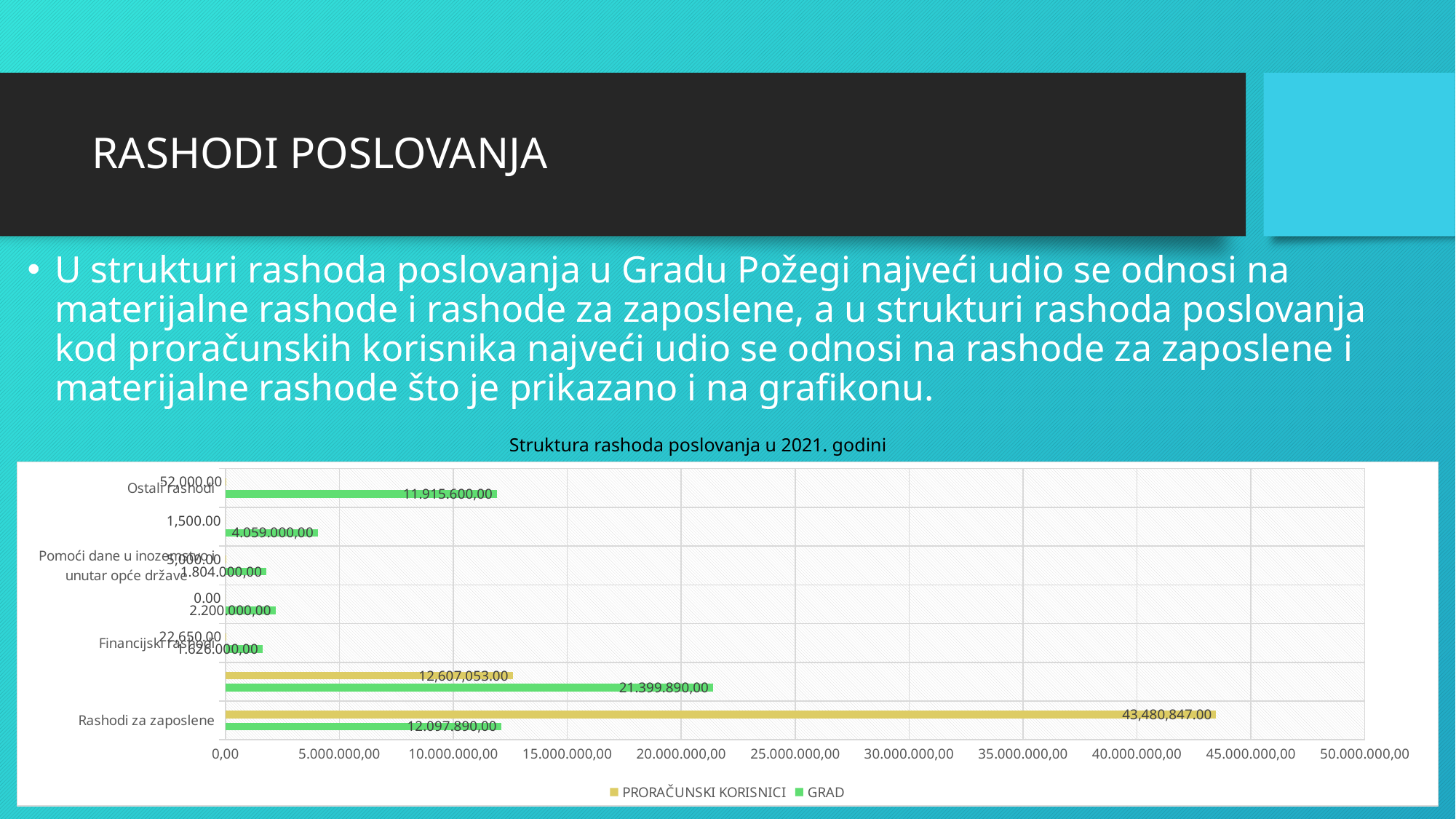
How many series does the chart legend list? 2 What is the GRAD value for Rashodi za zaposlene? 12.097.890,00 What kind of chart is shown on the slide? bar chart What is the GRAD value for Ostali rashodi? 11.915.600,00 How many categories are plotted on the chart? 7 What is the largest GRAD value shown on the chart? 21.399.890,00 What is the PRORAČUNSKI KORISNICI value for Rashodi za zaposlene? 43,480,847.00 Is the GRAD value for Rashodi za zaposlene greater or less than 10.000.000,00? greater What is the title of the chart? Struktura rashoda poslovanja u 2021. godini For Rashodi za zaposlene, which series has the larger value, PRORAČUNSKI KORISNICI or GRAD? PRORAČUNSKI KORISNICI Which series is drawn in green? GRAD Which category has the highest PRORAČUNSKI KORISNICI value? Rashodi za zaposlene